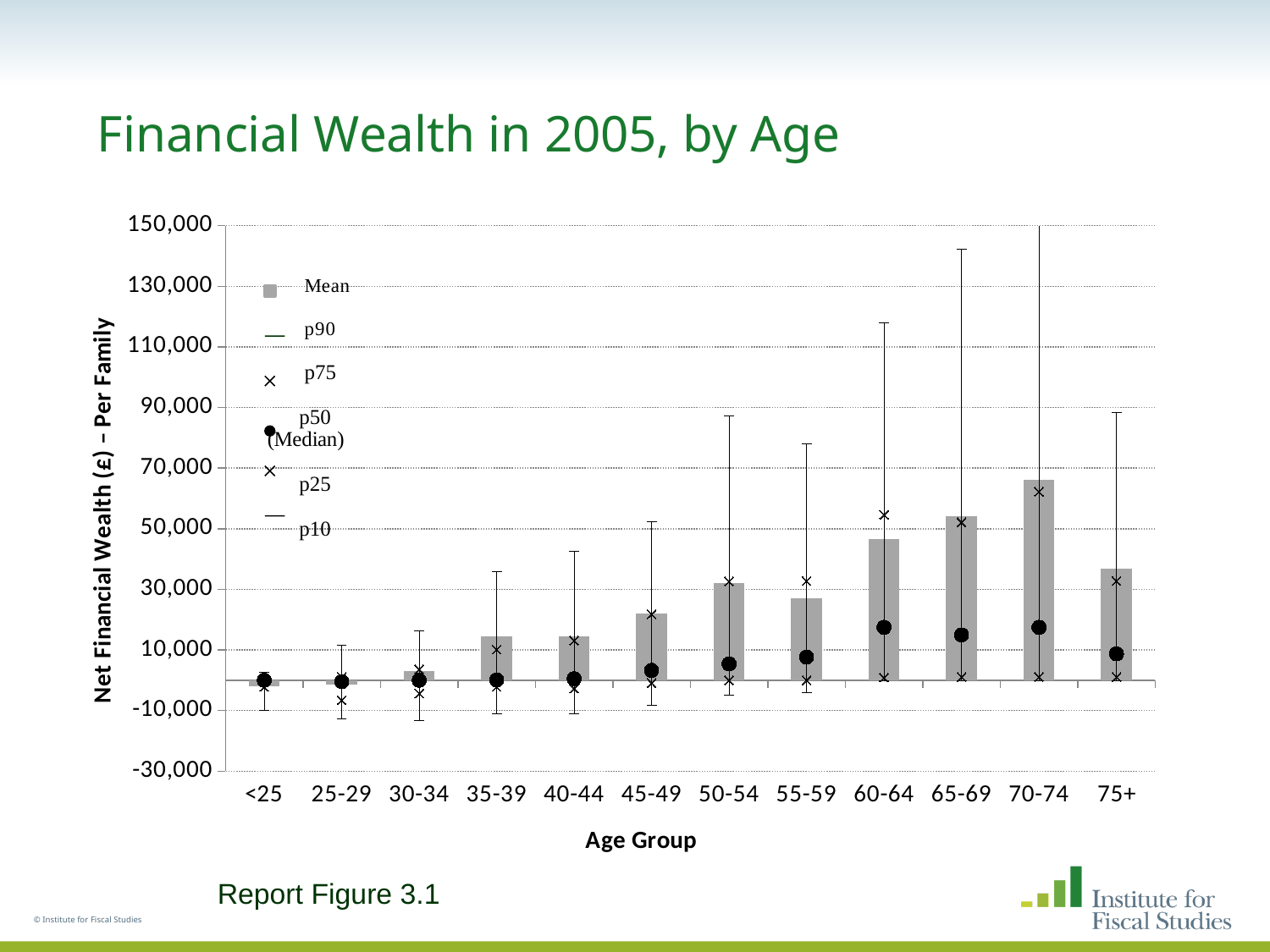
Is the mean net financial wealth for the 60-64 age group greater or less than 30,000? greater Which has the larger mean net financial wealth, the 45-49 age group or the 50-54 age group? 50-54 What is the title of the chart? Financial Wealth in 2005, by Age Is the mean net financial wealth for the 75+ age group greater or less than 50,000? less Is the mean net financial wealth for the 70-74 age group greater or less than 50,000? greater How many age groups are shown on the x axis? 12 Which age group has the highest mean net financial wealth? 70-74 Which has the larger mean net financial wealth, the 70-74 age group or the 75+ age group? 70-74 What is the label on the y axis? Net Financial Wealth (£) – Per Family How many series does the legend list? 6 What kind of chart is shown on the slide? bar chart